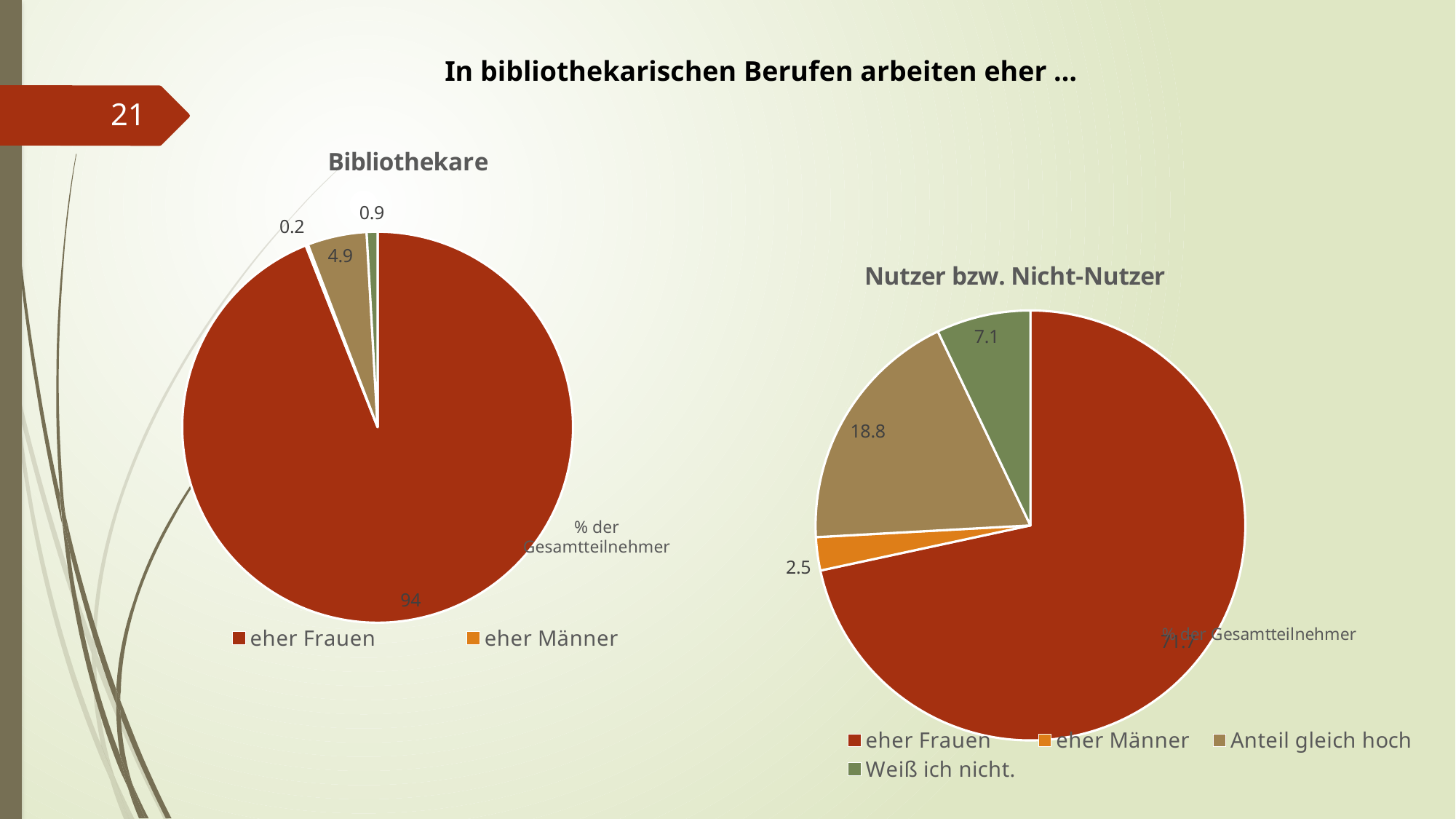
What type of chart is the 'Bibliothekare' chart? pie chart In the 'Nutzer bzw. Nicht-Nutzer' chart, what is the value for 'Weiß ich nicht.'? 7.1 In the 'Bibliothekare' chart, what is the value for 'eher Frauen'? 94 In the 'Bibliothekare' chart, what is the value for 'eher Männer'? 0.2 Which chart has the larger value for 'eher Frauen', 'Bibliothekare' or 'Nutzer bzw. Nicht-Nutzer'? Bibliothekare In the 'Nutzer bzw. Nicht-Nutzer' chart, what is the value for 'Anteil gleich hoch'? 18.8 In the 'Nutzer bzw. Nicht-Nutzer' chart, what is the value for 'eher Frauen'? 71.7 In the 'Nutzer bzw. Nicht-Nutzer' chart, what is the difference between 'Anteil gleich hoch' and 'Weiß ich nicht.'? 11.7 In the 'Nutzer bzw. Nicht-Nutzer' chart, which category has the smallest slice? eher Männer In the 'Bibliothekare' chart, which category has the largest slice? eher Frauen How many entries does the legend of the 'Nutzer bzw. Nicht-Nutzer' chart list? 4 In the 'Nutzer bzw. Nicht-Nutzer' chart, what is the value for 'eher Männer'? 2.5